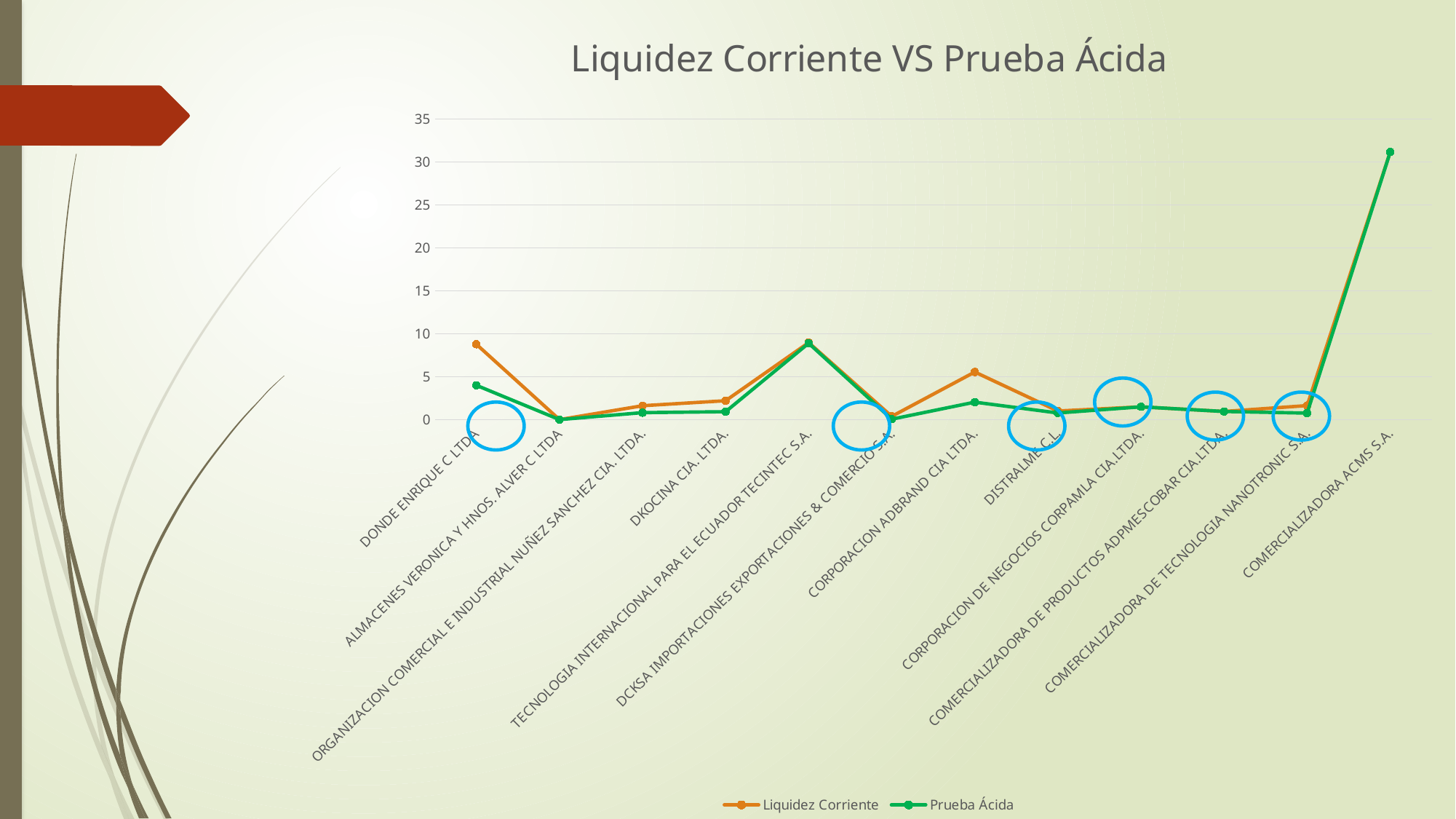
For CORPORACION ADBRAND CIA LTDA, which is larger: Liquidez Corriente or Prueba Ácida? Liquidez Corriente How many series does the legend list? 2 How many companies are plotted along the x axis? 12 Which company has the highest Liquidez Corriente value? COMERCIALIZADORA ACMS S.A. Is the Liquidez Corriente value for TECNOLOGIA INTERNACIONAL PARA EL ECUADOR TECINTEC S.A. greater or less than 5? greater What is the title of the chart? Liquidez Corriente VS Prueba Ácida Is the Liquidez Corriente value for DONDE ENRIQUE C LTDA greater or less than 5? greater Is the Prueba Ácida value for CORPORACION ADBRAND CIA LTDA greater or less than 5? less For DONDE ENRIQUE C LTDA, which is larger: Liquidez Corriente or Prueba Ácida? Liquidez Corriente What kind of chart is shown on the slide? Line chart Which company has the highest Prueba Ácida value? COMERCIALIZADORA ACMS S.A.